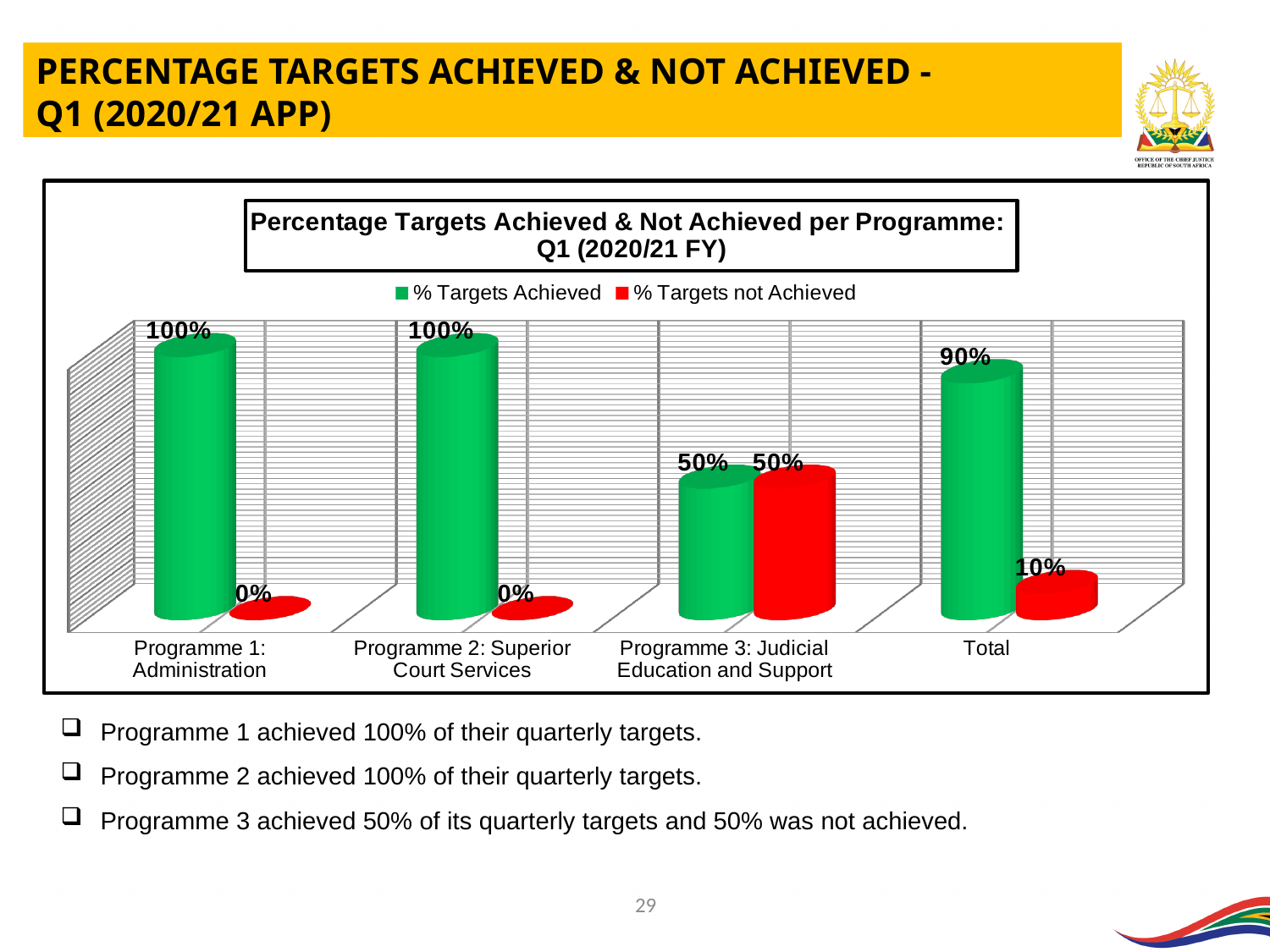
How many categories are shown on the x axis of the chart? 4 What is the % Targets Achieved value for Total? 90% What kind of chart is shown on the slide? Bar chart What is the difference between the % Targets Achieved for Programme 1: Administration and for Total? 10% What is the % Targets not Achieved value for Programme 2: Superior Court Services? 0% What percentage of targets were achieved by Programme 1: Administration? 100% Which category has the highest % Targets not Achieved? Programme 3: Judicial Education and Support How many series does the legend list? 2 Which is larger: the % Targets Achieved for Total or the % Targets Achieved for Programme 3: Judicial Education and Support? Total What percentage of targets were not achieved by Programme 3: Judicial Education and Support? 50% Which category has the lowest % Targets Achieved? Programme 3: Judicial Education and Support Which colour represents % Targets not Achieved in the chart? Red